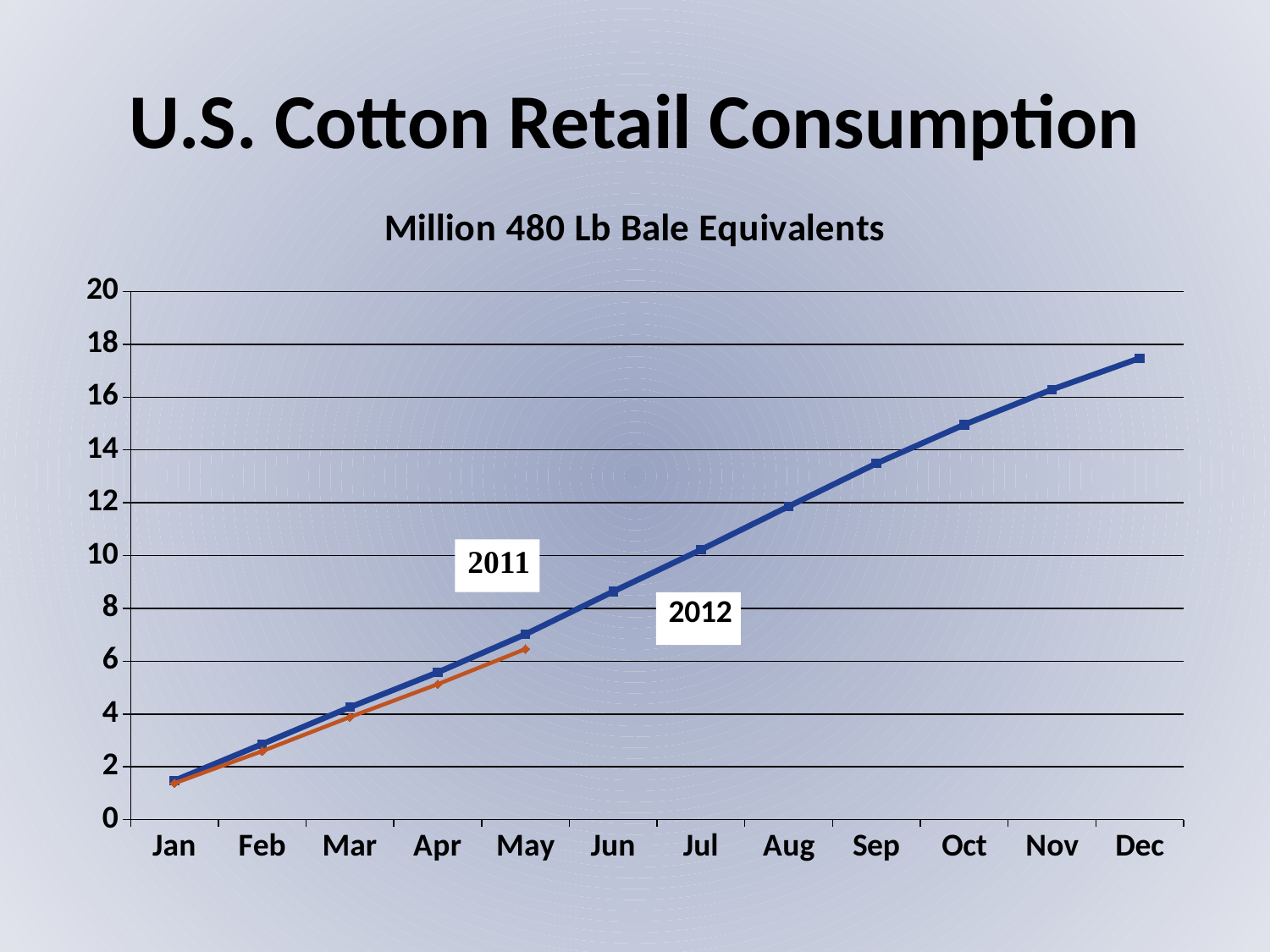
How many data series are plotted on the chart? 2 What kind of chart is shown on the slide? line chart What is the title of the chart on the slide? U.S. Cotton Retail Consumption In May, which series has the higher value, 2011 or 2012? 2011 What unit is the chart's data expressed in, according to the subtitle? Million 480 Lb Bale Equivalents In which month is the 2012 series at its highest? May Which series extends all the way to Dec? 2011 In which month is the 2012 series at its lowest? Jan How many months are shown along the x axis? 12